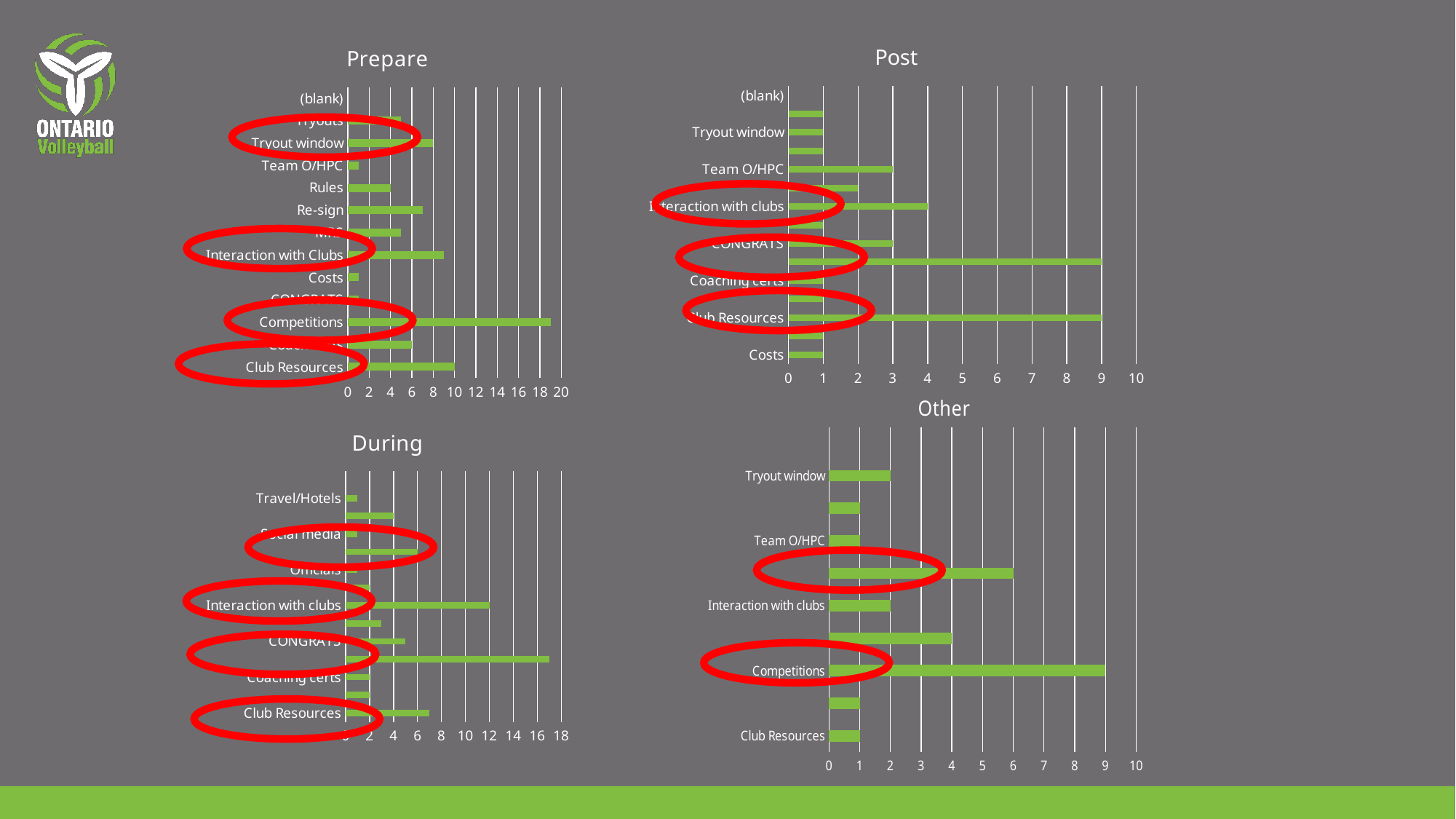
In the Prepare chart, what is the value for Club Resources? 10 In the Other chart, what is the value for Tryout window? 2 In the Prepare chart, which category has the highest value? Competitions What kind of chart is the Prepare chart? bar chart In the During chart, what is the value for Interaction with clubs? 12 In the Prepare chart, is the value for Competitions greater or less than 16? greater In the Other chart, what is the value for Competitions? 9 In the Post chart, what is the value for Interaction with clubs? 4 In the Other chart, which category has the highest value? Competitions In the Post chart, which is larger: Interaction with clubs or Team O/HPC? Interaction with clubs In the Other chart, what is the difference between Competitions and Tryout window? 7 In the Post chart, what is the value for Team O/HPC? 3